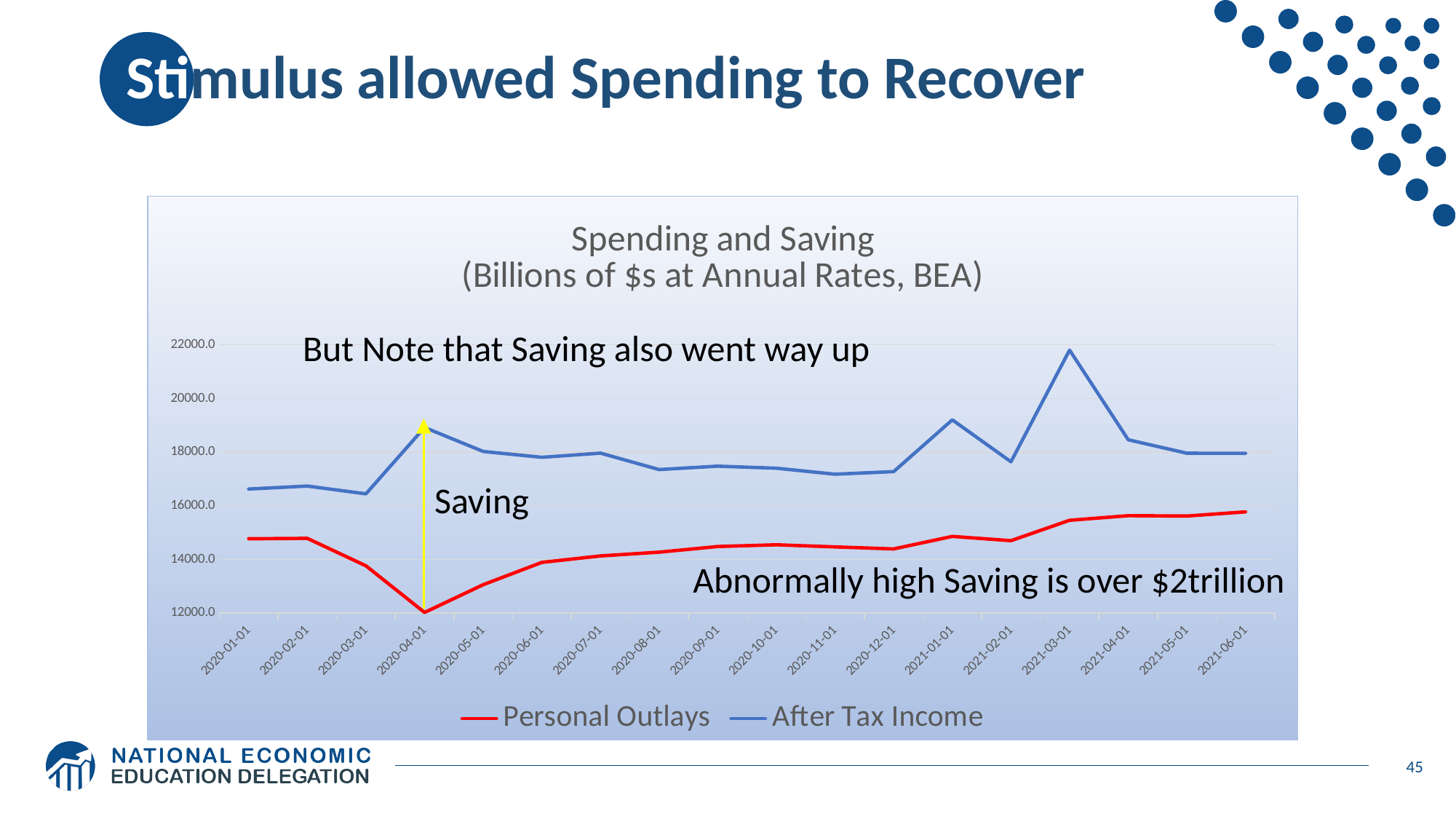
Is the value for Personal Outlays at 2020-01-01 greater or less than 16000.0? less On which date does Personal Outlays reach its lowest value? 2020-04-01 What is the title of the chart? Spending and Saving (Billions of $s at Annual Rates, BEA) Do Personal Outlays rise or fall from 2020-04-01 to 2021-06-01? rise What kind of chart is shown on the slide? line chart Is the value for After Tax Income at 2020-01-01 greater or less than 16000.0? greater At 2020-04-01, which series has the larger value, Personal Outlays or After Tax Income? After Tax Income Is the value for After Tax Income at 2021-03-01 greater or less than 20000.0? greater How many dates are plotted along the x axis? 18 What colour is the After Tax Income line? blue On which date does After Tax Income reach its highest value? 2021-03-01 How many series does the legend list? 2